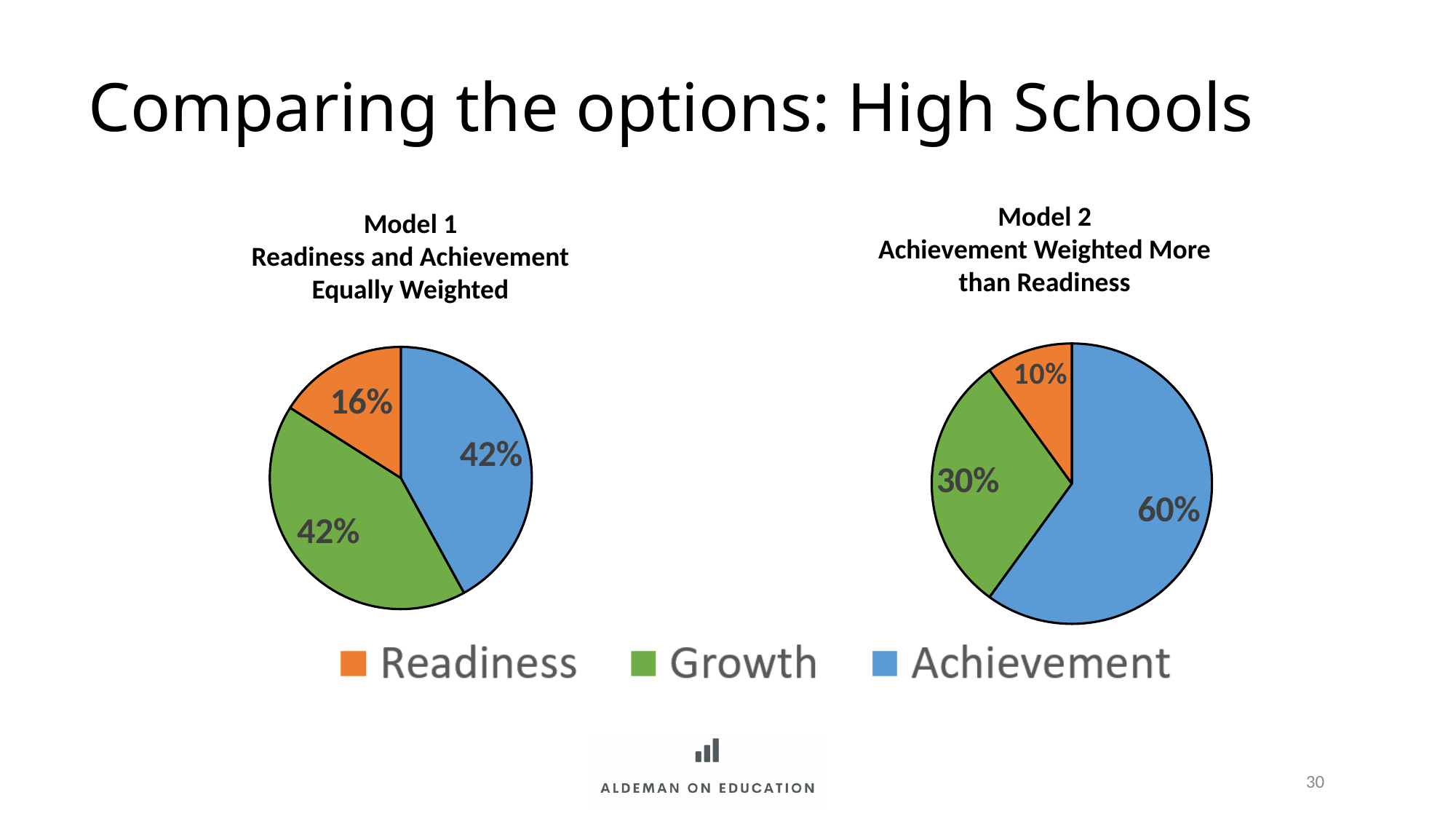
Which colour represents Growth in the legend? Green In the Model 2 pie chart, which category has the largest slice? Achievement In the Model 1 pie chart, what share is Growth? 42% What kind of chart is used for Model 1? Pie chart In the Model 2 pie chart, what share is Achievement? 60% In the Model 1 pie chart, which category has the smallest slice? Readiness In the Model 2 pie chart, what share is Readiness? 10% In the Model 1 pie chart, what share is Readiness? 16% In the Model 2 pie chart, what is the difference between the Achievement and Growth shares? 30% Which is larger in the Model 2 pie chart: Growth or Readiness? Growth How many slices does the Model 1 pie chart have? 3 How many entries does the legend list? 3